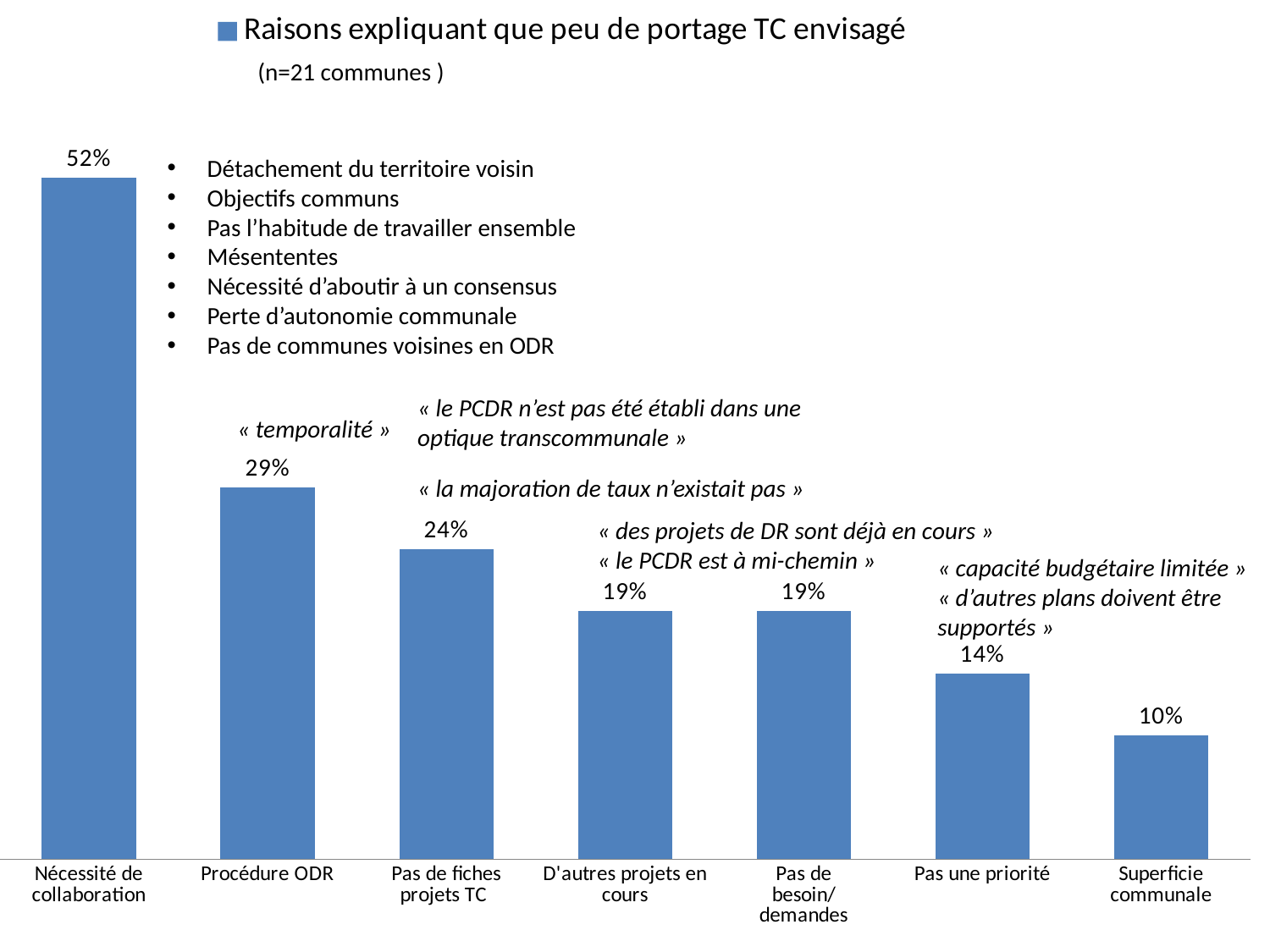
Which is larger, Pas une priorité or Pas de fiches projets TC? Pas de fiches projets TC What is the title of the chart? Raisons expliquant que peu de portage TC envisagé What is the value for Pas de fiches projets TC? 24% Which category has the highest value? Nécessité de collaboration Which category has the lowest value? Superficie communale Do the values rise or fall from left to right along the x axis? Fall What is the value for Nécessité de collaboration? 52% What is the value for Superficie communale? 10% What is the difference between Nécessité de collaboration and Procédure ODR? 23% How many categories are shown on the x axis? 7 What is the value for Procédure ODR? 29% What kind of chart is this? Bar chart